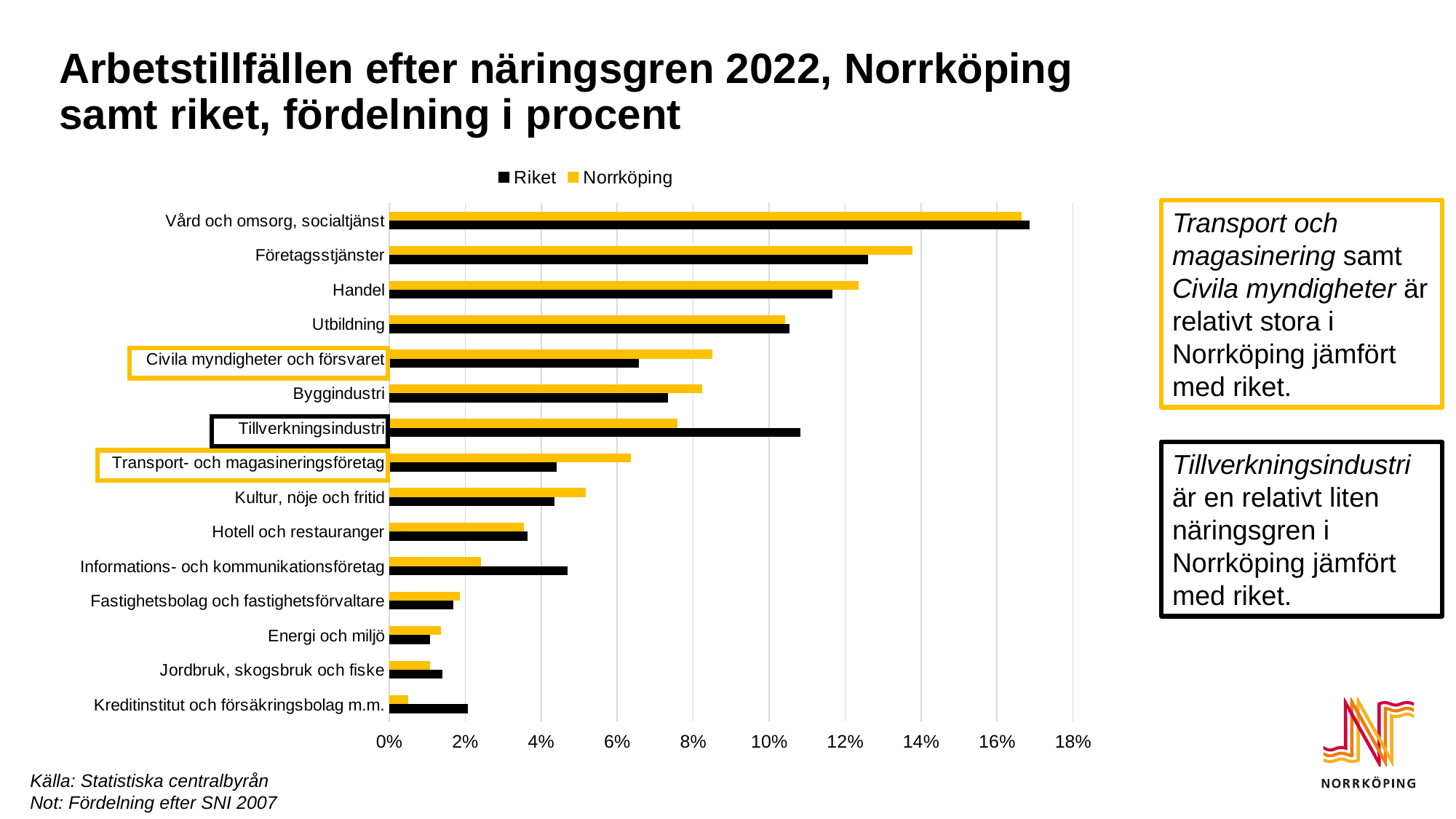
Which category has the highest value for Norrköping? Vård och omsorg, socialtjänst Which colour represents Norrköping in the chart? Yellow What source is cited for the chart data? Statistiska centralbyrån How many industry categories are plotted on the chart? 15 How many series does the legend list? 2 What kind of chart is shown on the slide? Bar chart Is the Norrköping value for Civila myndigheter och försvaret greater or less than 8%? greater Is the Riket value for Tillverkningsindustri greater or less than 10%? greater For Tillverkningsindustri, which is larger: the value for Riket or for Norrköping? Riket Is the Norrköping value for Informations- och kommunikationsföretag greater or less than 4%? less For Transport- och magasineringsföretag, which is larger: the value for Riket or for Norrköping? Norrköping Which category has the lowest value for Norrköping? Kreditinstitut och försäkringsbolag m.m.